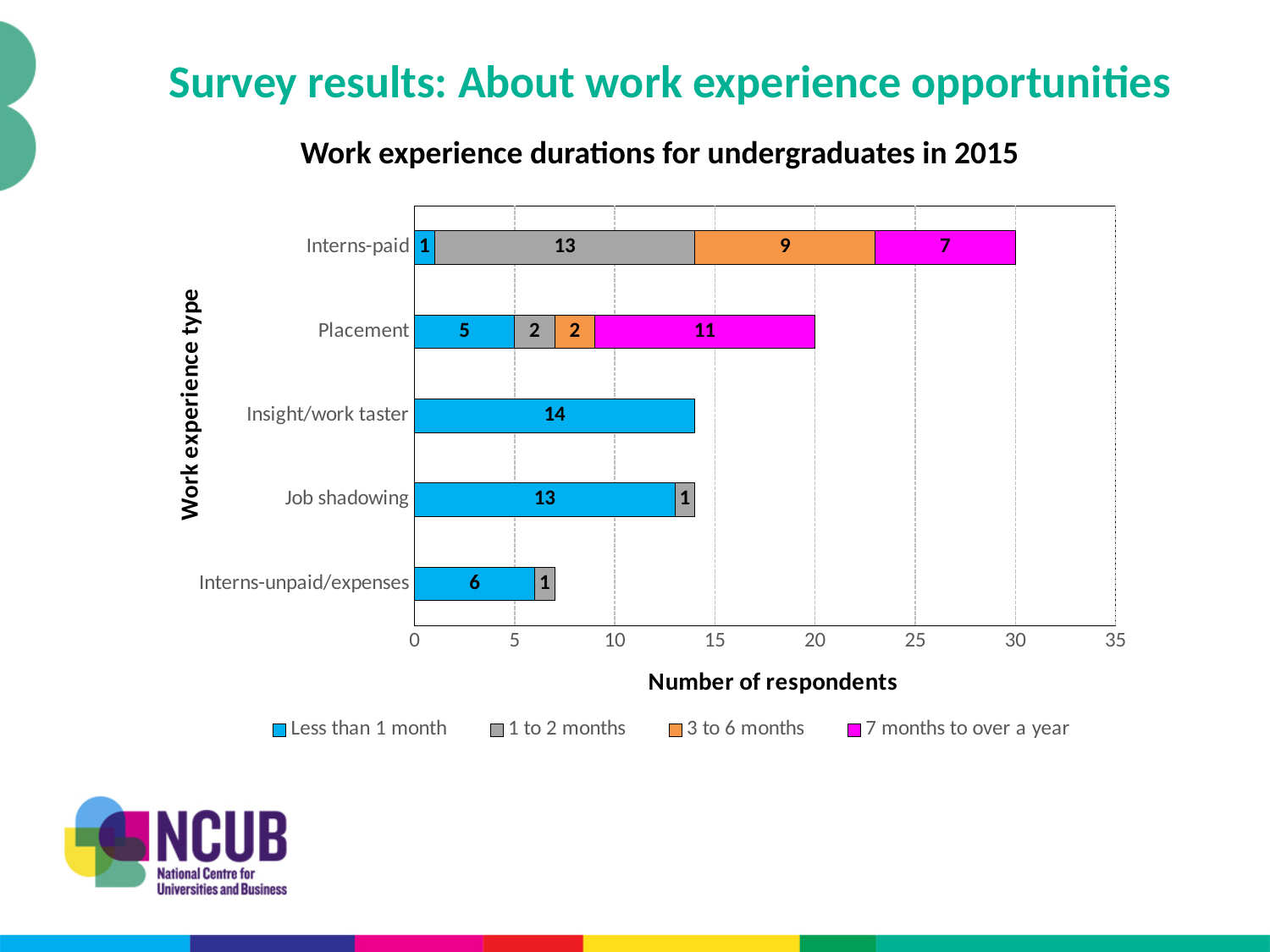
Which is larger: the 'Less than 1 month' value for Job shadowing or for Interns-unpaid/expenses? Job shadowing How many series does the legend list? 4 What is the total of the stacked bar for Interns-unpaid/expenses? 7 Which work experience type has the highest total number of respondents? Interns-paid What kind of chart is shown on the slide? Stacked bar chart What is the value for '7 months to over a year' in the Placement bar? 11 What is the value for '1 to 2 months' in the Interns-paid bar? 13 What is the total of the stacked bar for Placement? 20 What is the total of the stacked bar for Interns-paid? 30 What is the difference between the '3 to 6 months' value for Interns-paid and the '3 to 6 months' value for Placement? 7 What is the value for 'Less than 1 month' in the Insight/work taster bar? 14 Which work experience type has the lowest total number of respondents? Interns-unpaid/expenses